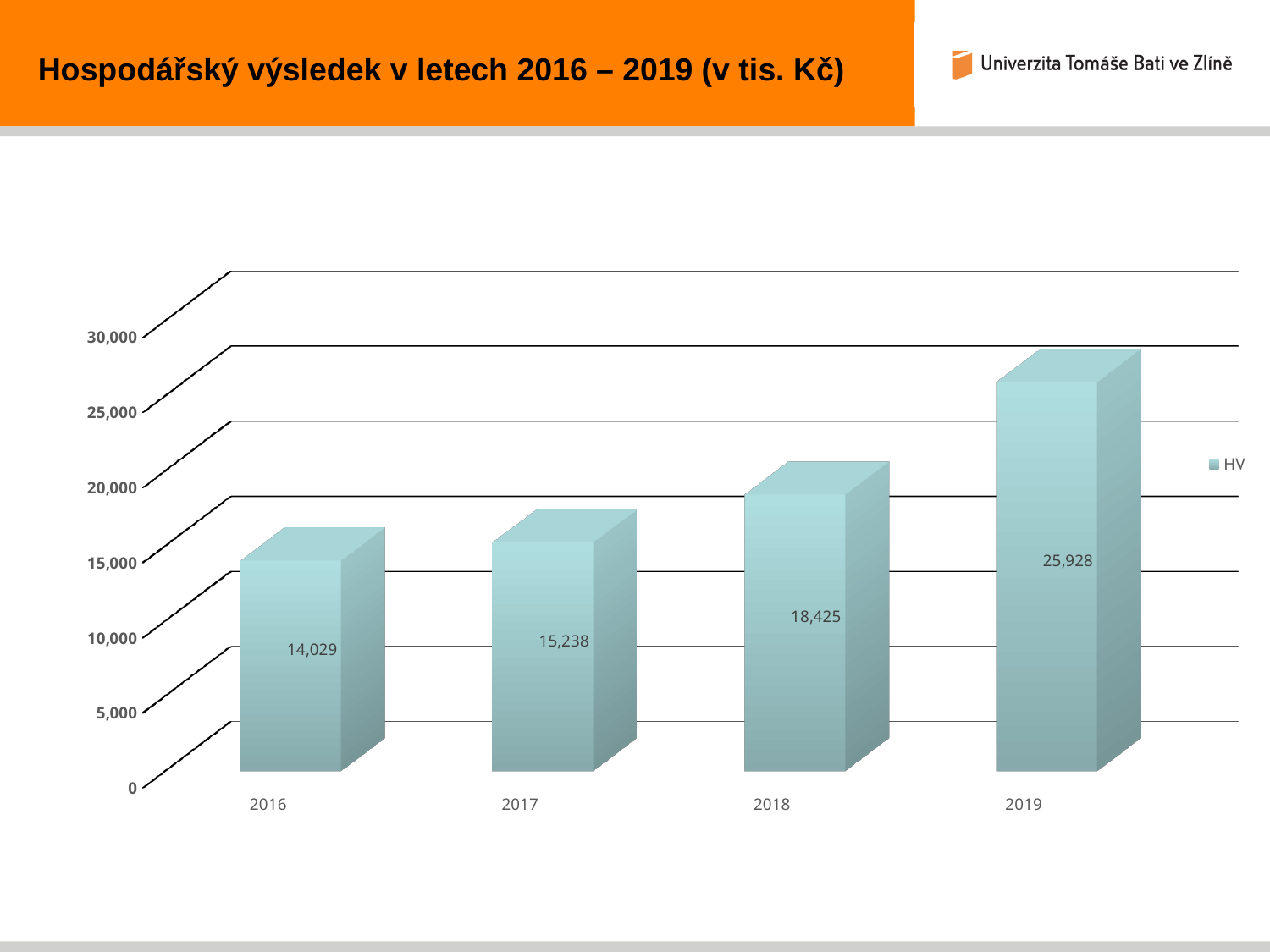
What is the value for 2016? 14,029 Which year has the lowest value? 2016 How many years are shown on the x axis? 4 What is the value for 2017? 15,238 What is the value for 2018? 18,425 Which year has the highest value? 2019 What kind of chart is shown on the slide? bar chart Do the values rise or fall from 2016 to 2019? rise What is the difference between the values for 2017 and 2016? 1,209 What is the difference between the values for 2019 and 2018? 7,503 Which is larger, the value for 2018 or the value for 2017? 2018 What is the value for 2019? 25,928